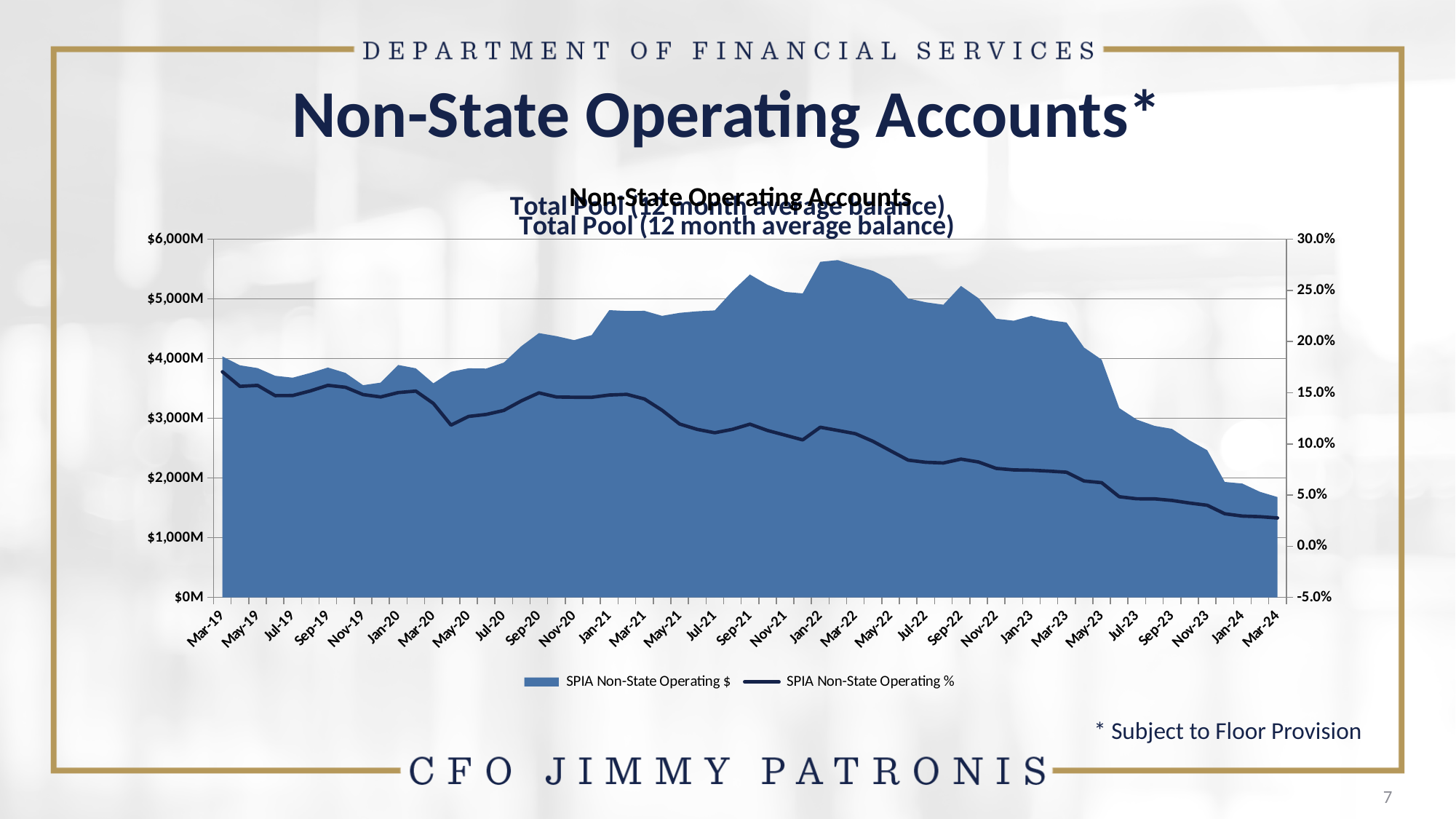
Is the SPIA Non-State Operating % value for Mar-19 greater or less than 15.0%? greater Which is larger, the SPIA Non-State Operating $ value for Sep-21 or for Mar-24? Sep-21 What are the two series named in the legend? SPIA Non-State Operating $ and SPIA Non-State Operating % Is the SPIA Non-State Operating $ value for Mar-24 greater or less than $2,000M? less What is the subtitle of the chart below 'Non-State Operating Accounts'? Total Pool (12 month average balance) Is the SPIA Non-State Operating % value for Mar-24 greater or less than 5.0%? less Does the SPIA Non-State Operating % line rise or fall overall from Mar-19 to Mar-24? fall What kind of chart is shown on the slide? Area chart with a line overlay At which month does the SPIA Non-State Operating $ area reach its lowest point? Mar-24 How many series does the chart legend list? 2